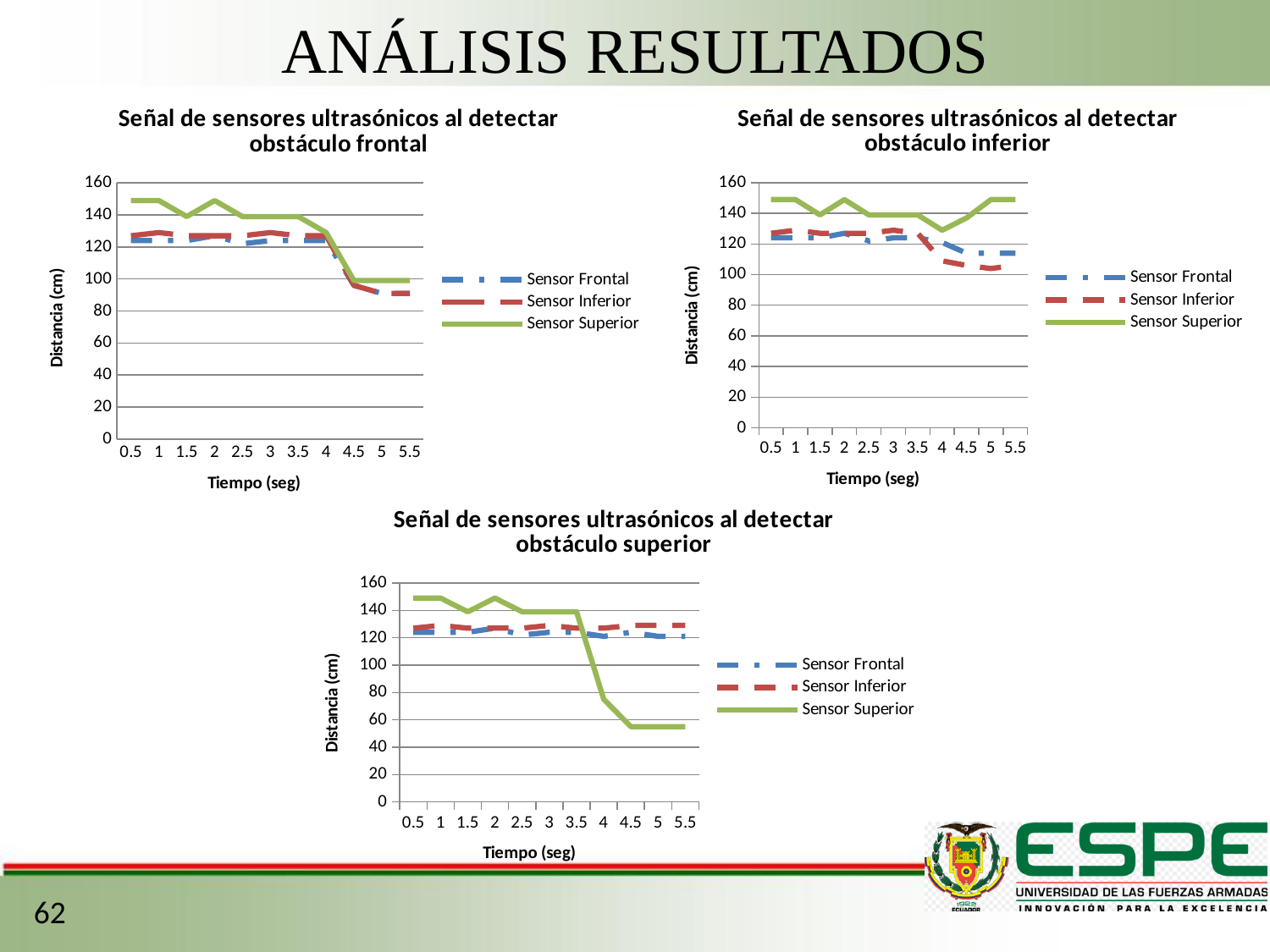
In the 'obstáculo superior' chart, is the value of Sensor Superior at 5.5 seg greater or less than 80? less What is the y-axis label of the 'obstáculo frontal' chart? Distancia (cm) In the 'obstáculo superior' chart, which series has the larger value at 5.5 seg, Sensor Superior or Sensor Inferior? Sensor Inferior How many time points are shown on the x axis of the 'obstáculo inferior' chart? 11 What is the x-axis label of the 'obstáculo superior' chart? Tiempo (seg) In the 'obstáculo frontal' chart, is the value of Sensor Superior at 0.5 seg greater or less than 140? greater How many series does the legend list in the 'obstáculo superior' chart? 3 In the 'obstáculo superior' chart, does the Sensor Superior series rise or fall from 3.5 seg to 4.5 seg? Fall In the 'obstáculo inferior' chart, is the value of Sensor Inferior at 5 seg greater or less than 120? less In the 'obstáculo inferior' chart, which series has the larger value at 5.5 seg, Sensor Superior or Sensor Inferior? Sensor Superior What kind of chart is the 'Señal de sensores ultrasónicos al detectar obstáculo frontal' chart? Line chart